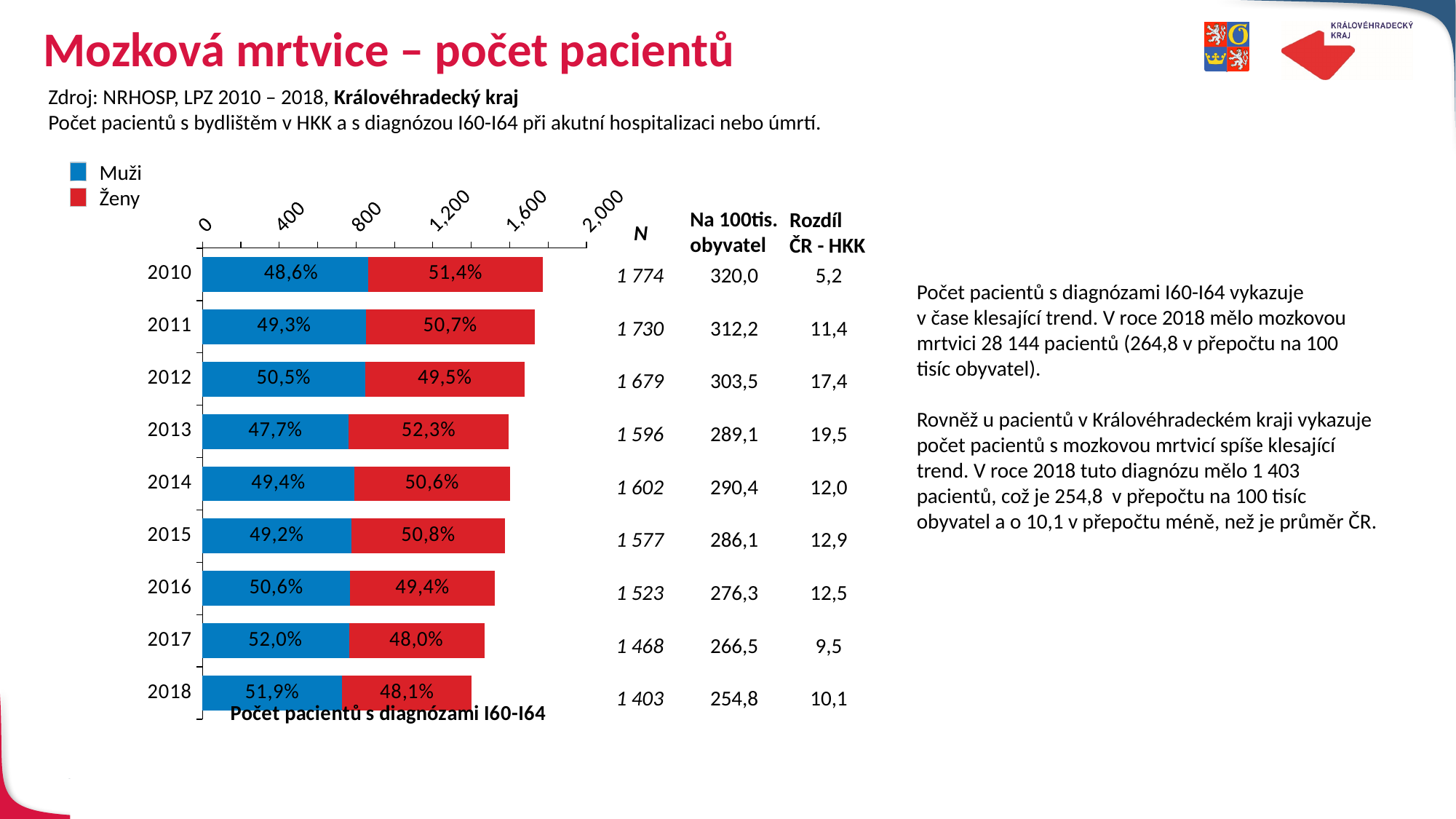
What is the share of Muži in 2010? 48,6% Do the total bar lengths rise or fall from 2010 to 2018? fall In 2017, which is larger, the share of Muži or the share of Ženy? Muži How many years are shown on the chart? 9 Is the total length of the 2010 bar greater or less than 1,600? greater How many series does the chart legend list? 2 What kind of chart is shown on the slide? Stacked bar chart What is the difference between the Ženy share and the Muži share in 2013? 4,6 percentage points In which year is the share of Muži the lowest? 2013 In which year is the share of Muži the highest? 2017 What is the share of Muži in 2018? 51,9% What is the share of Ženy in 2013? 52,3%